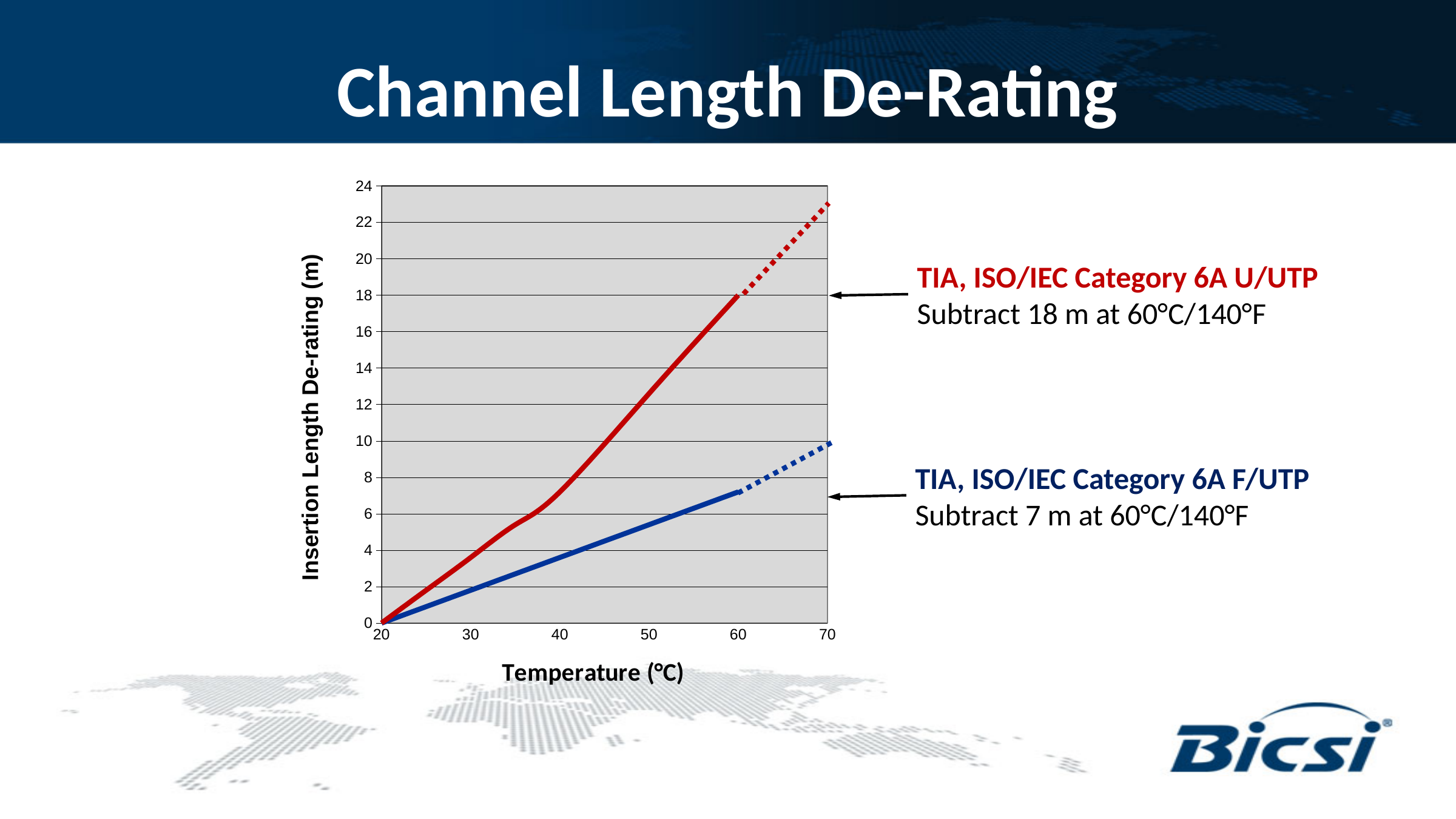
What is the insertion length de-rating for TIA, ISO/IEC Category 6A F/UTP at 60°C? 7 m What is the label of the x axis? Temperature (°C) Do the de-rating values rise or fall as temperature increases along the x axis? rise What kind of chart is shown on the slide? line chart What is the difference between the U/UTP and F/UTP de-rating values at 60°C? 11 m Which series has the larger de-rating at 60°C, Category 6A U/UTP or Category 6A F/UTP? Category 6A U/UTP Is the value for Category 6A U/UTP at 40°C greater or less than 6? greater What is the insertion length de-rating for TIA, ISO/IEC Category 6A U/UTP at 60°C? 18 m How many data series are plotted on the chart? 2 What colour is the line for TIA, ISO/IEC Category 6A F/UTP? blue